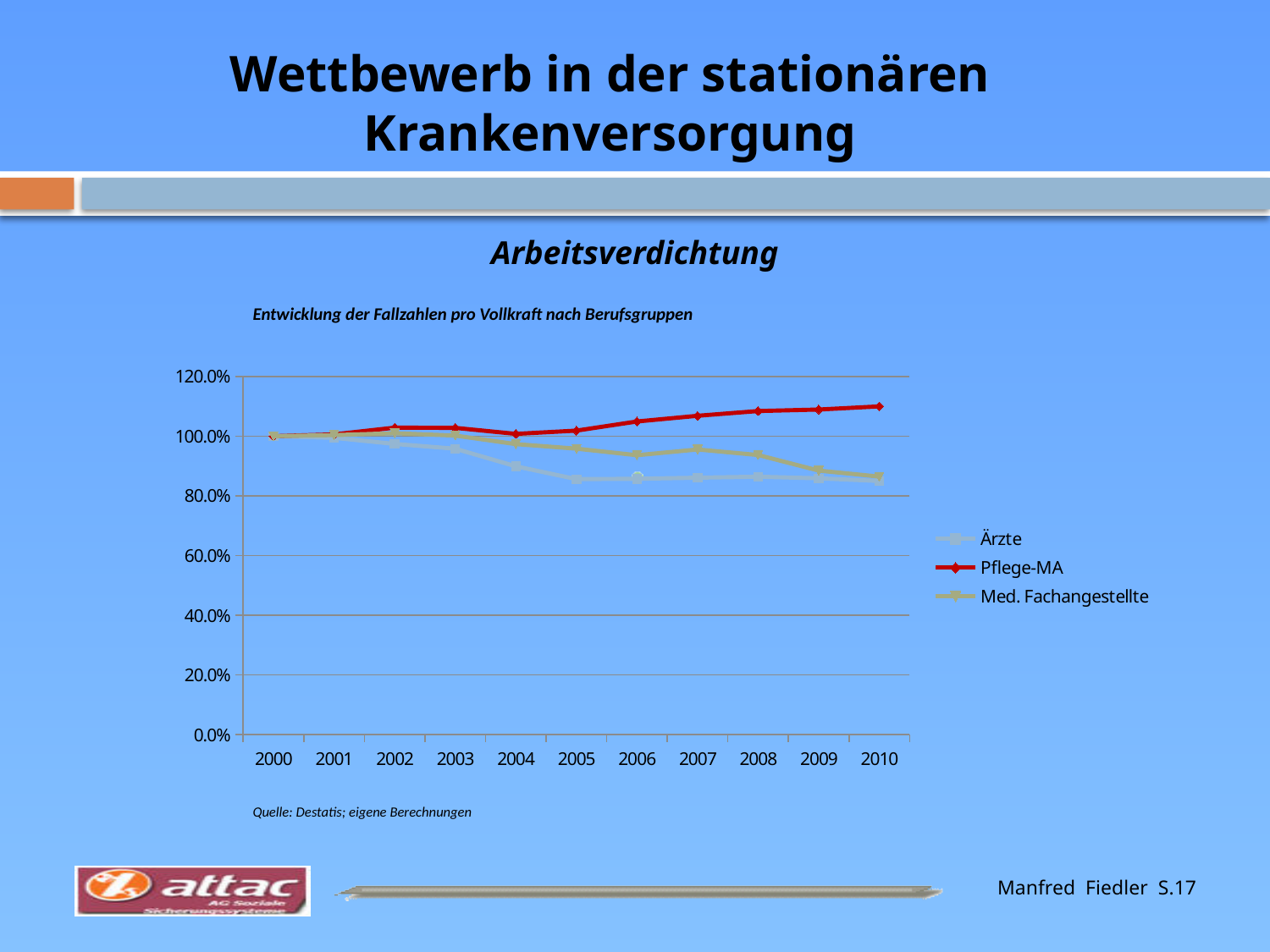
Does the Pflege-MA series rise or fall from 2000 to 2010? rise How many series does the legend list? 3 Which series has the highest value in 2010? Pflege-MA What kind of chart is shown on the slide? line chart How many years are shown on the x axis? 11 Is the value for Ärzte in 2010 greater or less than 100.0%? less Does the Ärzte series rise or fall from 2000 to 2010? fall Is the value for Med. Fachangestellte in 2010 greater or less than 80.0%? greater Is the value for Pflege-MA in 2010 greater or less than 100.0%? greater What is the title of the chart? Entwicklung der Fallzahlen pro Vollkraft nach Berufsgruppen What is the value for Pflege-MA in 2000? 100.0% Which series has the lowest value in 2005? Ärzte